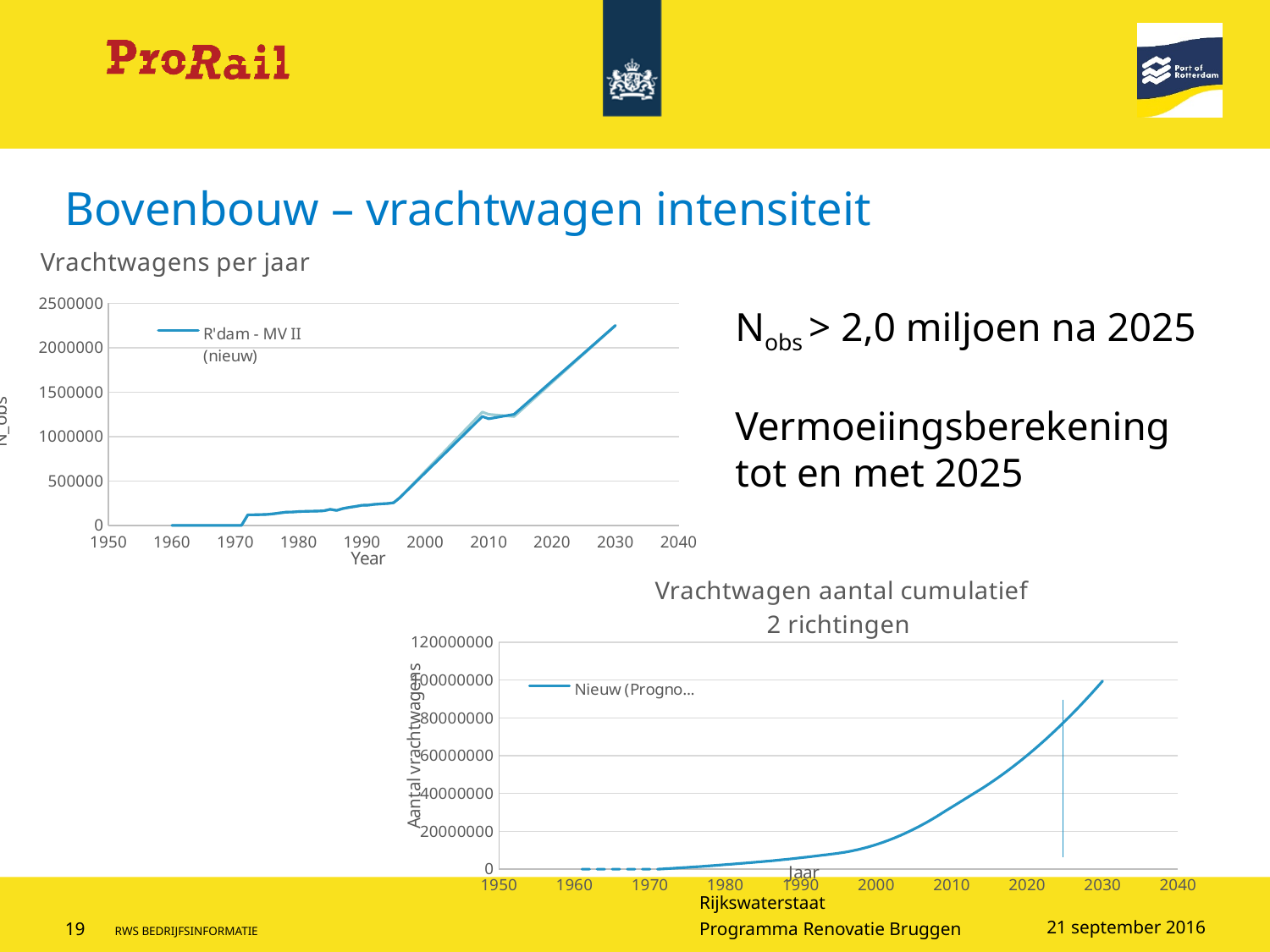
In the 'Vrachtwagen aantal cumulatief 2 richtingen' chart, do the values rise or fall from 1980 to 2030? rise In the 'Vrachtwagens per jaar' chart, is the value for 1990 greater or less than 500000? less What kind of chart is the 'Vrachtwagens per jaar' chart? line chart In the 'Vrachtwagens per jaar' chart, do the values rise or fall from 1970 to 2030? rise What is the x-axis label of the 'Vrachtwagen aantal cumulatief 2 richtingen' chart? Jaar In the 'Vrachtwagens per jaar' chart, is the value for 2030 greater or less than 2000000? greater What is the series name shown in the legend of the 'Vrachtwagens per jaar' chart? R'dam - MV II (nieuw) In the 'Vrachtwagen aantal cumulatief 2 richtingen' chart, is the value for 2030 greater or less than 80000000? greater What kind of chart is the 'Vrachtwagen aantal cumulatief 2 richtingen' chart? line chart How many series does the legend of the 'Vrachtwagens per jaar' chart list? 1